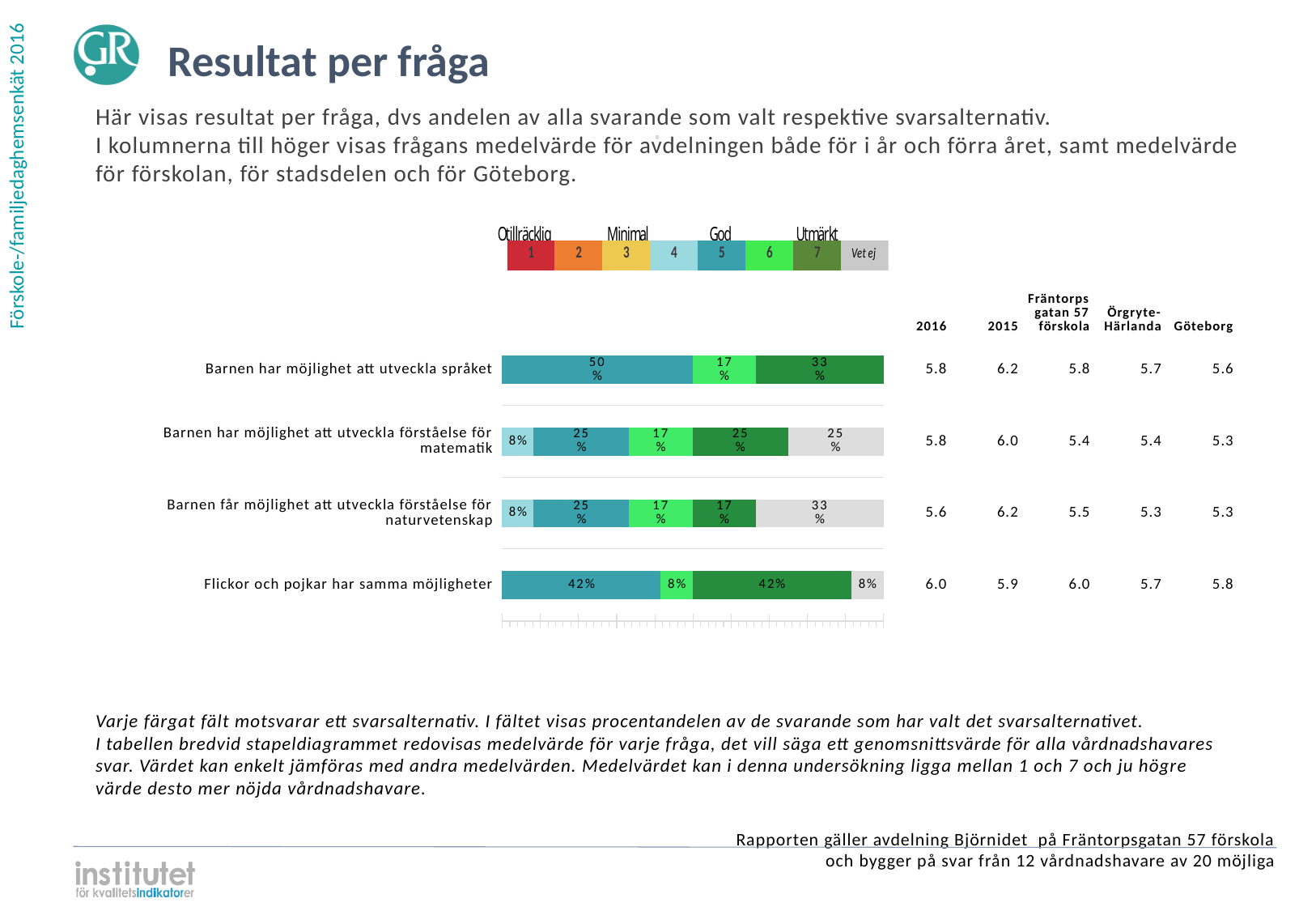
How many answer options are shown in the colour legend above the chart, including "Vet ej"? 8 For "Barnen har möjlighet att utveckla förståelse för matematik", which is larger: the share choosing option 5 or the share choosing option 6? Option 5 What is the 2016 mean value for "Barnen har möjlighet att utveckla förståelse för matematik"? 5.8 How many questions (categories) are shown as bars in the chart? 4 What is the difference between the 2015 and 2016 mean values for "Barnen har möjlighet att utveckla språket"? 0.4 What percentage of respondents chose answer option 7 (the dark green segment) for "Flickor och pojkar har samma möjligheter"? 42% Which question has the highest 2016 mean value? Flickor och pojkar har samma möjligheter What kind of chart is used to show the results per question? Stacked bar chart What percentage of respondents chose answer option 5 (the teal segment) for "Barnen har möjlighet att utveckla språket"? 50% What percentage of respondents answered "Vet ej" for "Barnen får möjlighet att utveckla förståelse för naturvetenskap"? 33% Which question has the lowest 2016 mean value? Barnen får möjlighet att utveckla förståelse för naturvetenskap What is the Göteborg mean value for "Flickor och pojkar har samma möjligheter"? 5.8